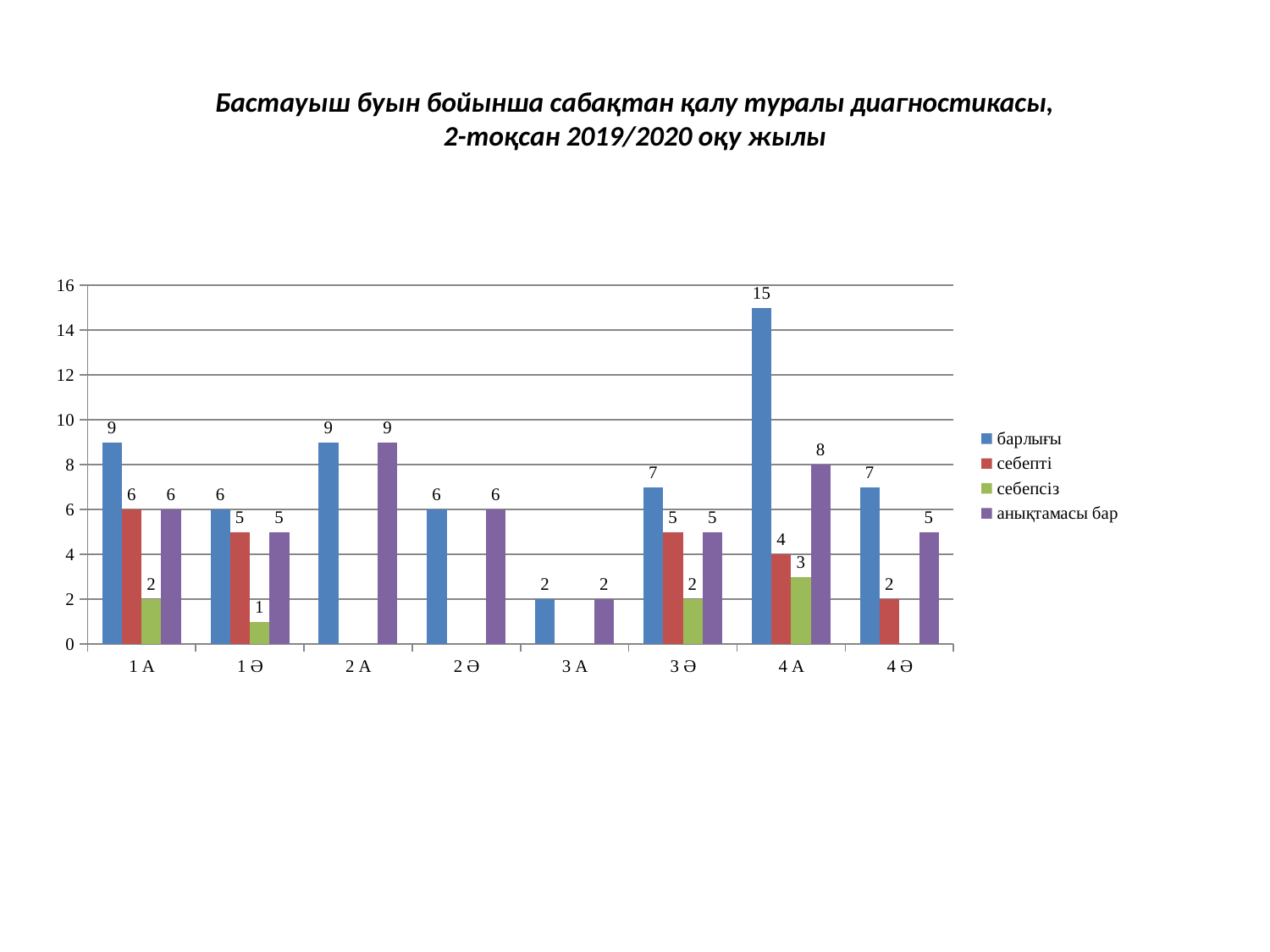
What is the value of анықтамасы бар for 2 А? 9 What is the difference between барлығы for 4 А and барлығы for 4 Ә? 8 What kind of chart is shown on the slide? Bar chart Which category has the highest барлығы value? 4 А Which series is shown in purple in the legend? анықтамасы бар What is the value of себепті for 1 Ә? 5 How many categories are shown on the x axis? 8 Which category has the lowest барлығы value? 3 А How many series does the legend list? 4 Which is larger: анықтамасы бар for 4 А or анықтамасы бар for 3 Ә? анықтамасы бар for 4 А What is the value of барлығы for 4 А? 15 What is the value of себепсіз for 4 А? 3